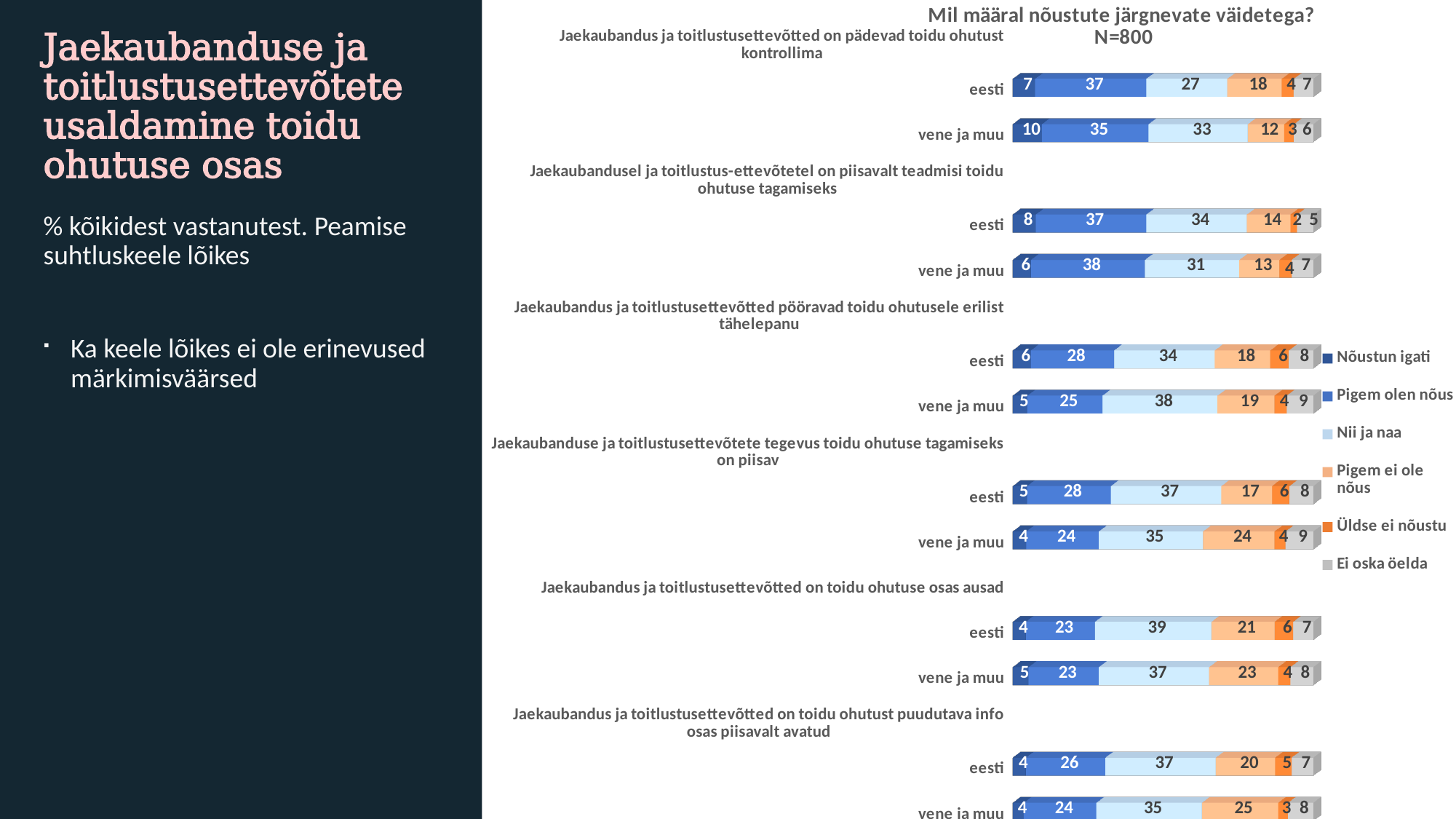
Across all bars, which row has the highest 'Nõustun igati' value? vene ja muu (pädevad toidu ohutust kontrollima) What is the sample size (N) shown in the chart title? N=800 For the statement 'Jaekaubanduse ja toitlustusettevõtete tegevus toidu ohutuse tagamiseks on piisav', what is the difference between the 'Pigem ei ole nõus' values for 'vene ja muu' and 'eesti'? 7 How many statements are compared in the chart? 6 How many series does the legend list? 6 For the statement 'Jaekaubandus ja toitlustusettevõtted on pädevad toidu ohutust kontrollima', what is the combined 'Nõustun igati' and 'Pigem olen nõus' value for 'eesti'? 44 For the statement 'Jaekaubandus ja toitlustusettevõtted on toidu ohutuse osas ausad', what is the 'Pigem ei ole nõus' value for 'vene ja muu'? 23 For the statement 'Jaekaubandusel ja toitlustus-ettevõtetel on piisavalt teadmisi toidu ohutuse tagamiseks', what is the 'Nii ja naa' value for 'eesti'? 34 For the statement 'Jaekaubandus ja toitlustusettevõtted on pädevad toidu ohutust kontrollima', what is the 'Nõustun igati' value for 'vene ja muu'? 10 What kind of chart is shown on the slide? stacked bar chart For the statement 'Jaekaubandus ja toitlustusettevõtted on toidu ohutust puudutava info osas piisavalt avatud', what is the 'Ei oska öelda' value for 'vene ja muu'? 8 For the statement 'Jaekaubandus ja toitlustusettevõtted pööravad toidu ohutusele erilist tähelepanu', which group has the larger 'Pigem olen nõus' value, 'eesti' or 'vene ja muu'? eesti